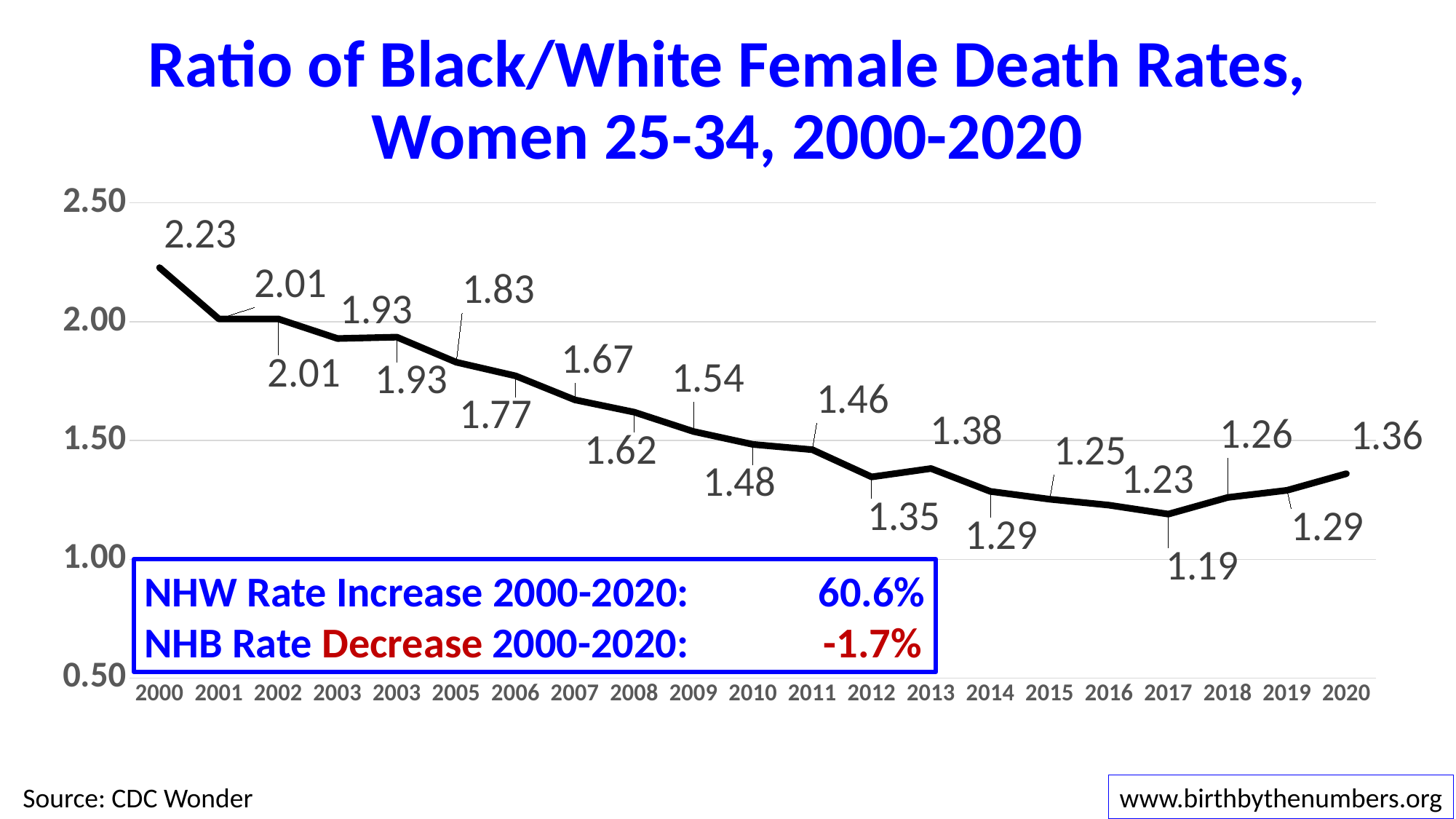
According to the text box on the chart, what was the NHW rate increase from 2000 to 2020? 60.6% What is the ratio value plotted for 2000? 2.23 Which year has the lowest ratio on the chart? 2017 What is the ratio value plotted for 2017? 1.19 What is the difference between the ratio in 2000 and the ratio in 2020? 0.87 What is the ratio value plotted for 2010? 1.48 What is the ratio value plotted for 2020? 1.36 What kind of chart is shown on the slide? line chart Which year has the highest ratio on the chart? 2000 Which year has the larger ratio, 2012 or 2013? 2013 Does the ratio generally rise or fall from 2000 to 2017? fall How many data points are plotted on the line? 21